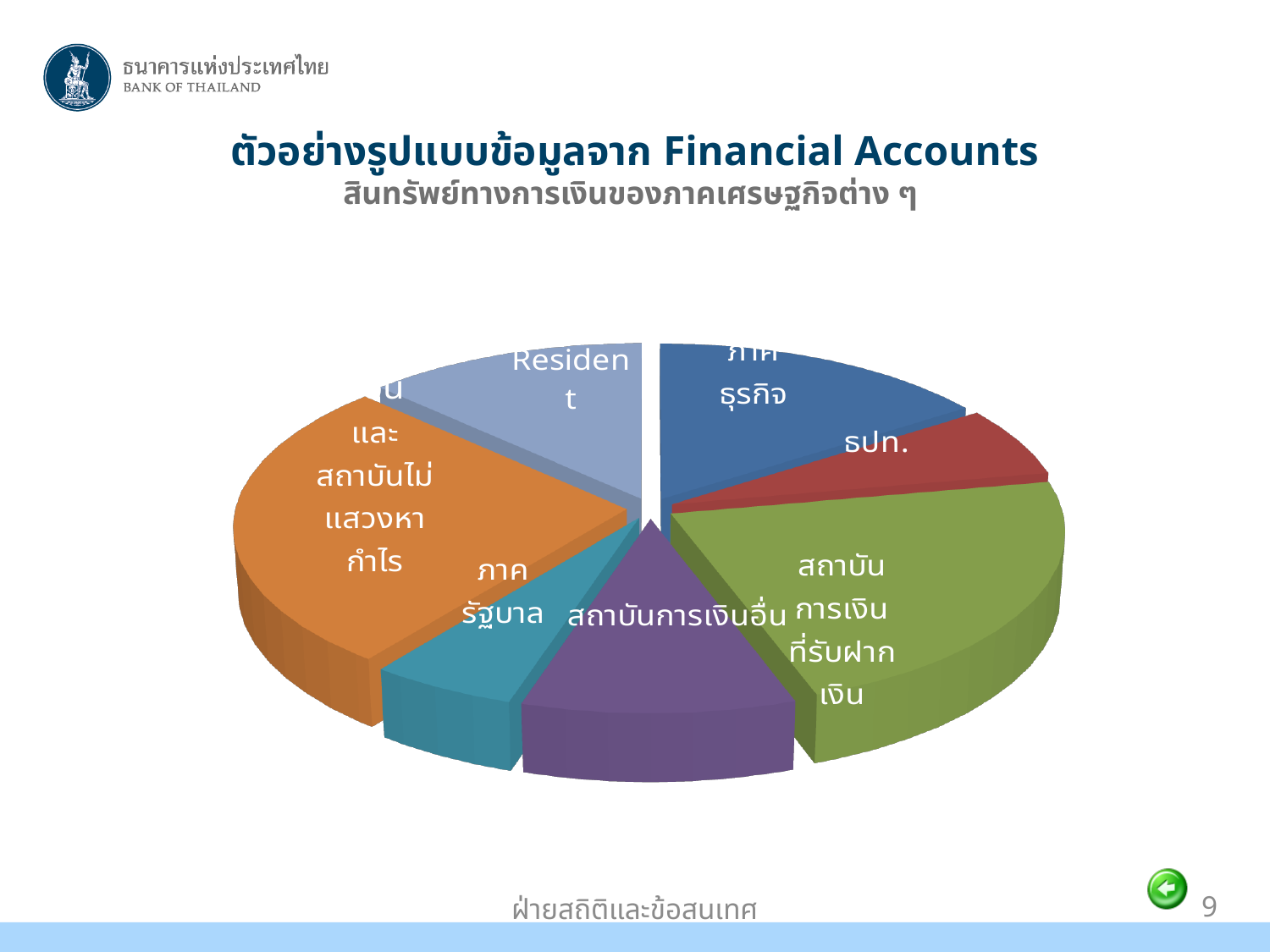
What colour is the สถาบันการเงินที่รับฝากเงิน slice of the pie chart? Green Which slice is larger, ธปท. or ภาคธุรกิจ? ภาคธุรกิจ Which slice is larger, ธปท. or สถาบันการเงินอื่น? สถาบันการเงินอื่น How many slices does the pie chart have? 7 What colour is the ธปท. slice of the pie chart? Red What kind of chart is shown on the slide? Pie chart Which slice is larger, ภาครัฐบาล or สถาบันการเงินที่รับฝากเงิน? สถาบันการเงินที่รับฝากเงิน